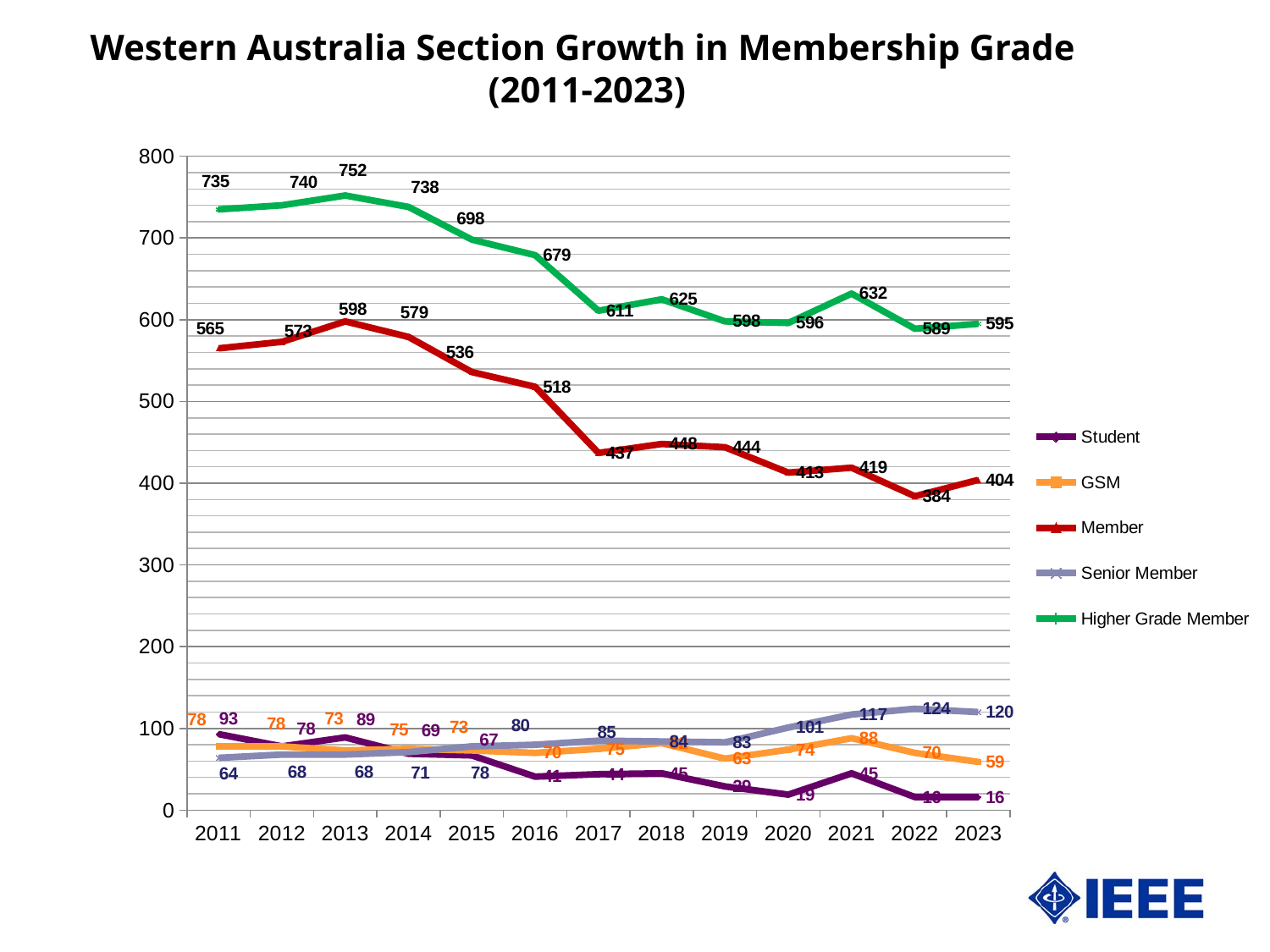
How many years are plotted on the x axis? 13 Which was larger in 2021: the Senior Member count or the GSM count? Senior Member What was the Senior Member count in 2022? 124 Is the Higher Grade Member value for 2017 greater or less than 600? greater What was the Higher Grade Member count in 2013? 752 How many series does the legend list? 5 By how much did the Member count fall from 2011 to 2023? 161 In which year did the Higher Grade Member series reach its highest value? 2013 What kind of chart is shown on the slide? Line chart What was the Member count in 2023? 404 In which year was the Member count at its lowest? 2022 Does the Member series generally rise or fall from 2011 to 2023? Fall